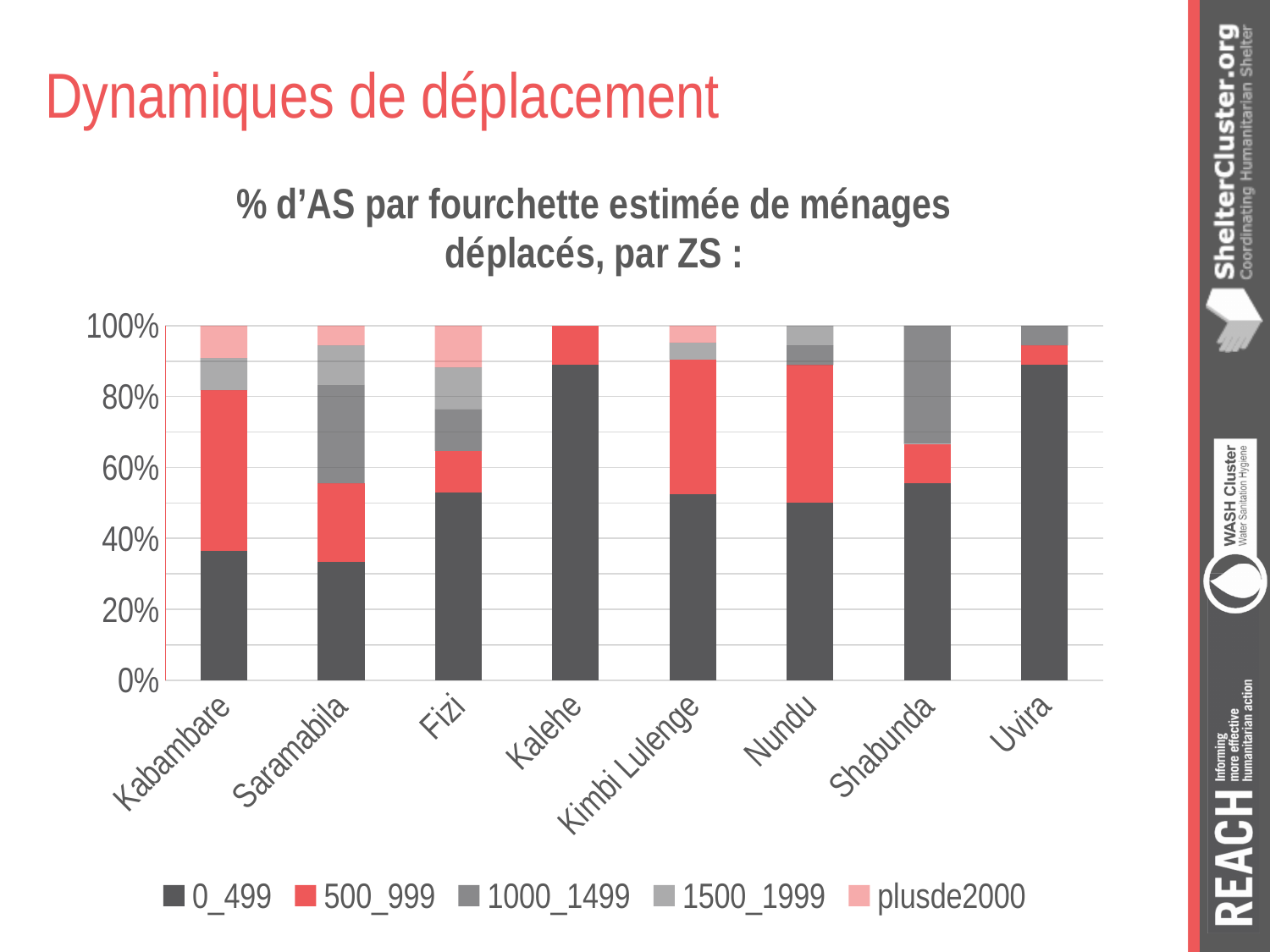
How many zones de santé (categories) are shown on the x axis of the chart? 8 Which has the larger 0_499 share, Kalehe or Kabambare? Kalehe What is the total of the stacked bar for Kalehe? 100% How many series does the chart legend list? 5 What kind of chart is shown on the slide? stacked bar chart Is the 0_499 value for Shabunda greater or less than 40%? greater Is the 0_499 value for Saramabila greater or less than 40%? less Which legend entry is shown in red? 500_999 Is the 0_499 value for Kalehe greater or less than 80%? greater What is the title of the chart? % d'AS par fourchette estimée de ménages déplacés, par ZS : Which has the larger 500_999 share, Kabambare or Fizi? Kabambare